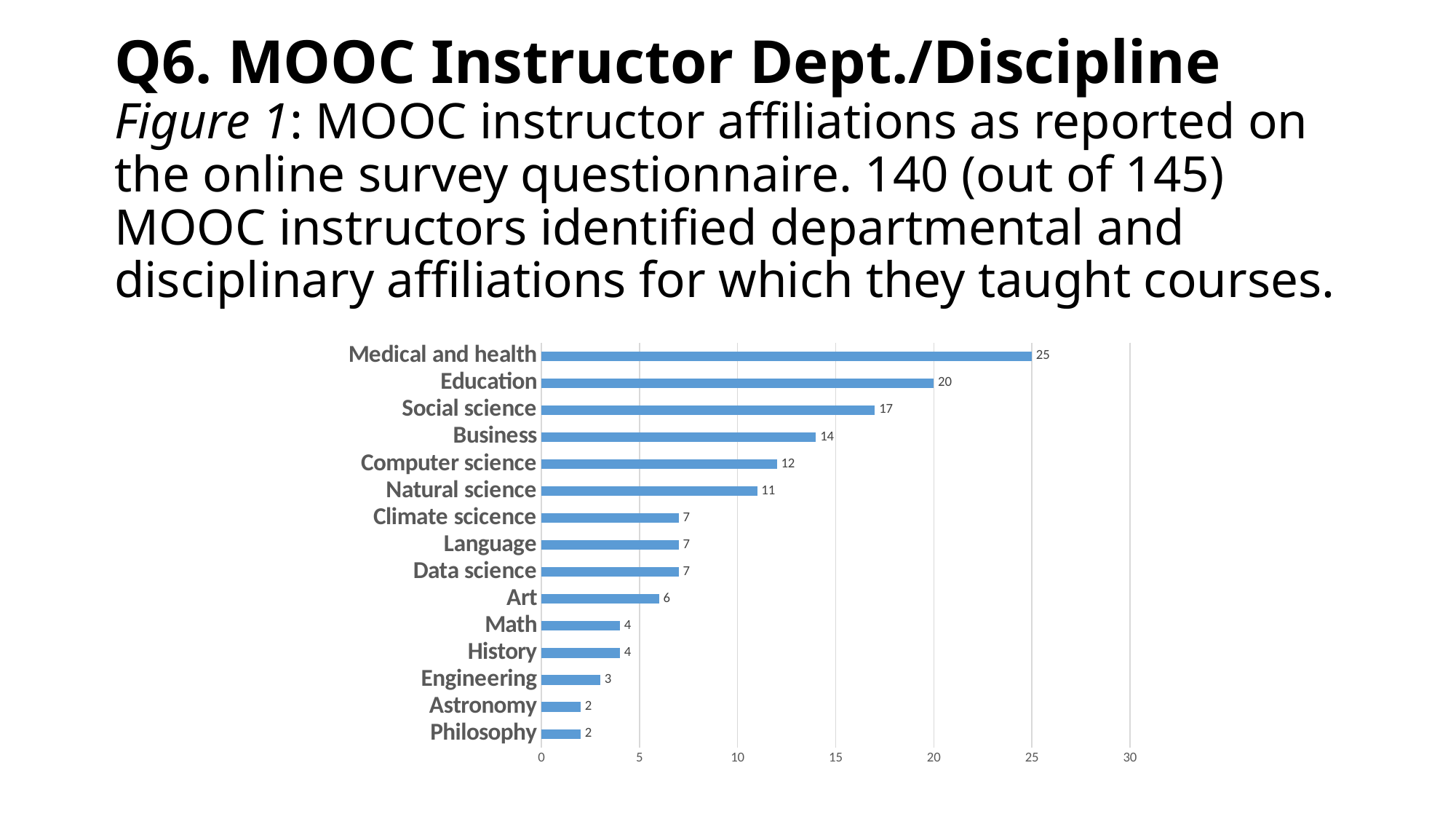
What is the value for Computer science? 12 What is the difference between the values for Social science and Natural science? 6 What is the value for Engineering? 3 What is the difference between the values for Education and Business? 6 Which is larger, the value for Art or the value for Math? Art Which category has the highest value? Medical and health What is the value for Medical and health? 25 Is the value for Education greater or less than 15? greater What is the value for Astronomy? 2 What kind of chart is shown on the slide? bar chart What is the highest value shown on the horizontal axis? 30 How many categories are shown in the chart? 15